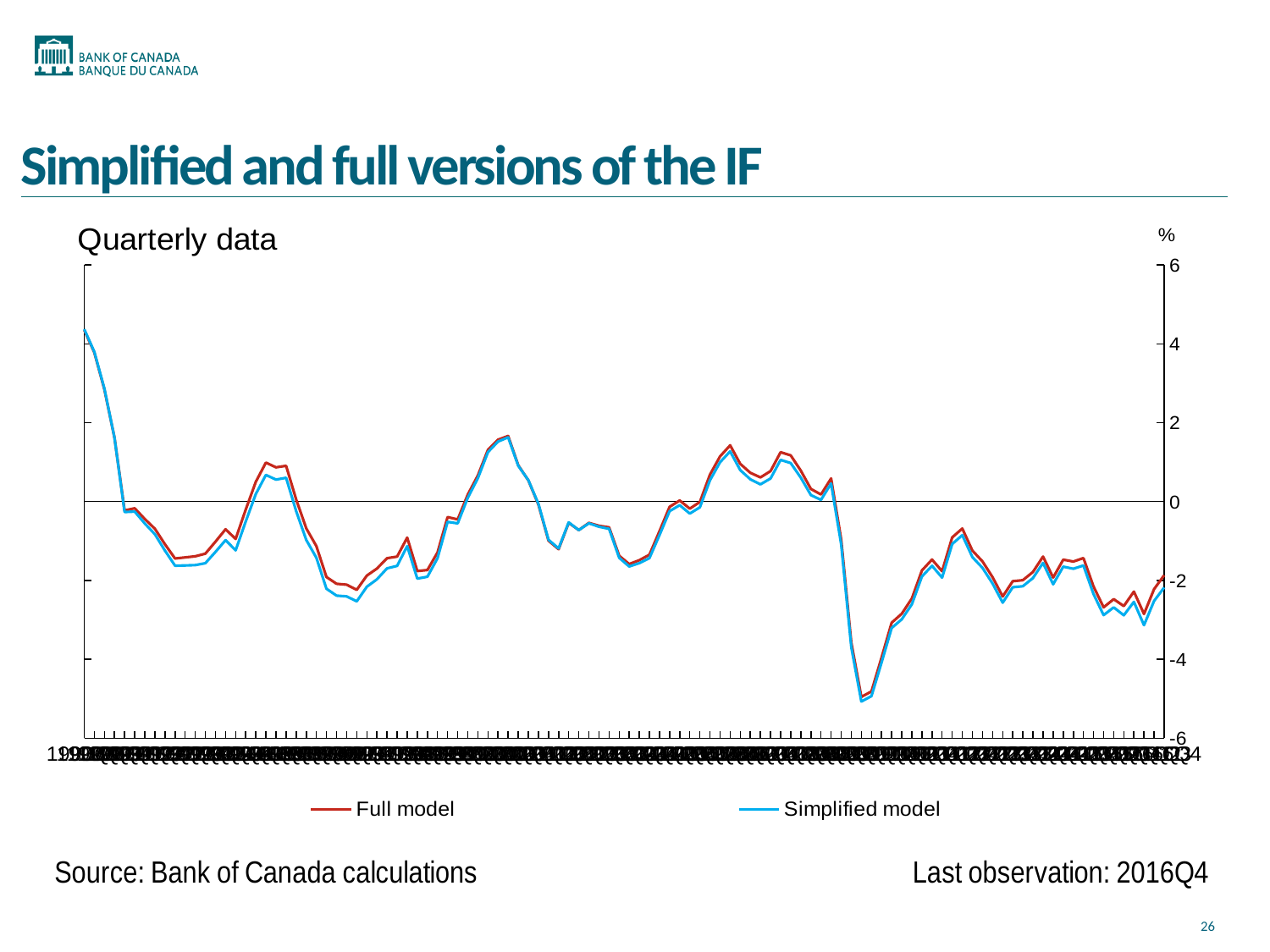
Is the lowest point of the Full model line greater or less than -4? less Overall, do the plotted values rise or fall from the start of the x axis to the end? fall Is the highest peak of the Full model in the middle of the chart greater or less than 2? less What is the title of the chart on the slide? Simplified and full versions of the IF Which series is drawn in blue? Simplified model Is the lowest point of the Simplified model greater or less than -6? greater How many series does the legend list? 2 What are the two series named in the legend? Full model and Simplified model What kind of chart is shown on the slide? Line chart